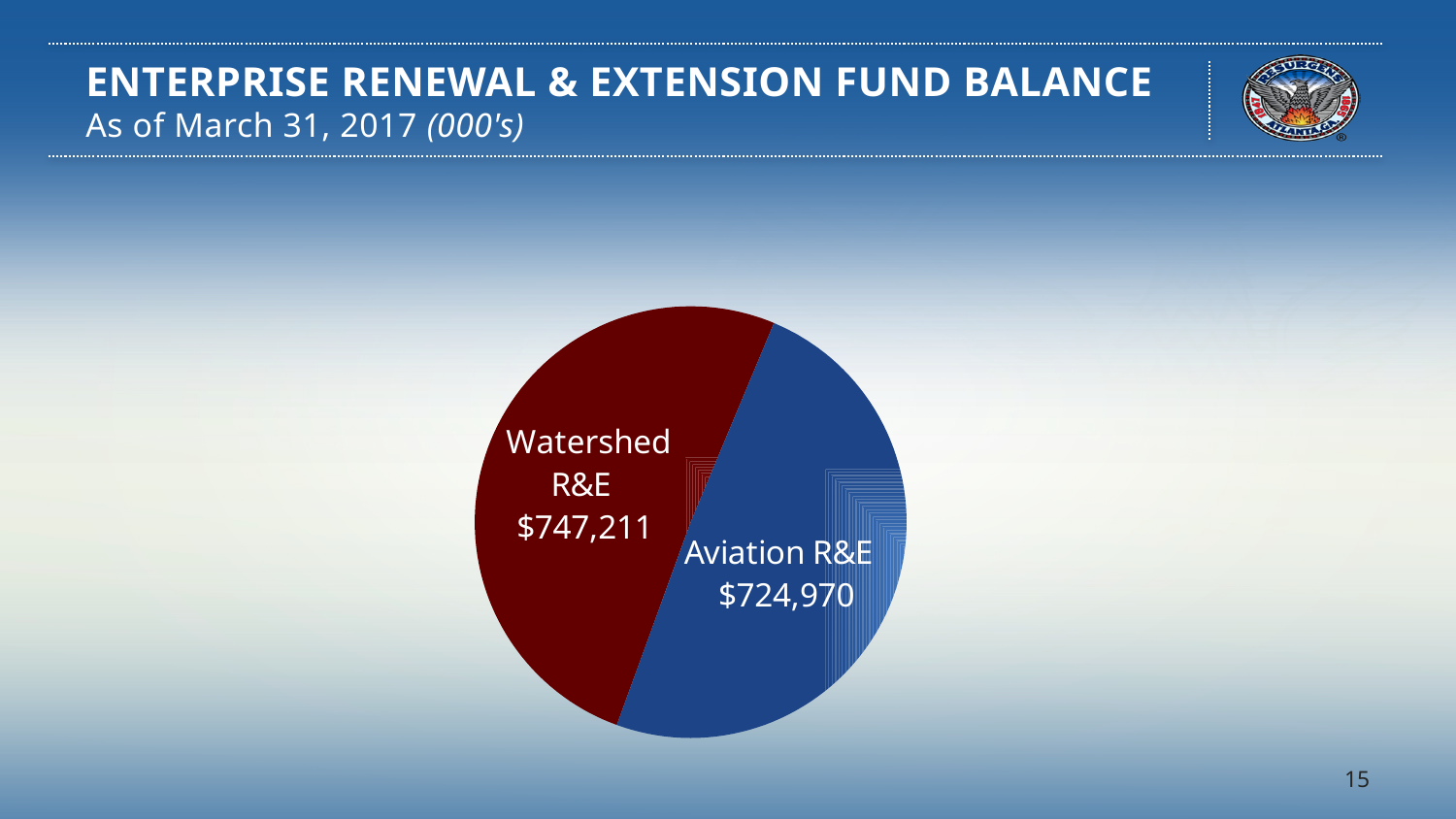
What type of chart is shown on the slide? pie chart Is the value for Watershed R&E larger or smaller than the value for Aviation R&E? larger How many slices does the pie chart have? 2 What is the value shown for Aviation R&E in the pie chart? $724,970 What colour is the Aviation R&E slice of the pie chart? blue What is the difference between the Watershed R&E and Aviation R&E values? $22,241 Which slice of the pie chart has the smaller value? Aviation R&E What is the value shown for Watershed R&E in the pie chart? $747,211 What is the combined total of the two slices in the pie chart? $1,472,181 Which slice of the pie chart has the larger value? Watershed R&E What is the title of the chart on the slide? Enterprise Renewal & Extension Fund Balance